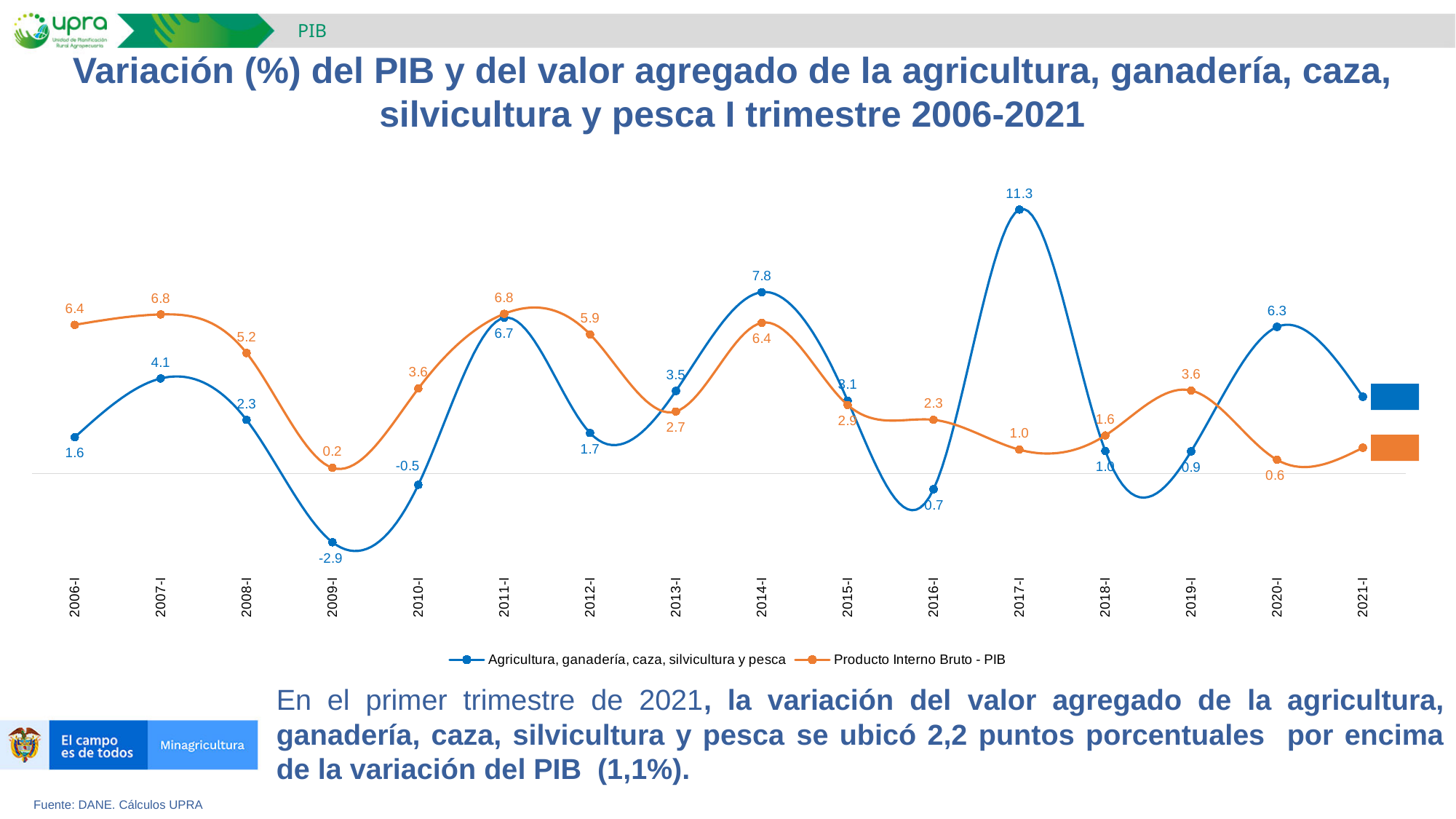
In 2012-I, which series has the larger value: Agricultura, ganadería, caza, silvicultura y pesca or Producto Interno Bruto - PIB? Producto Interno Bruto - PIB What kind of chart is shown on the slide? Line chart In which period does the Producto Interno Bruto - PIB series reach its lowest value? 2009-I What is the difference between the Agricultura, ganadería, caza, silvicultura y pesca value and the PIB value in 2014-I? 1.4 How many series does the legend list? 2 In which period does the Agricultura, ganadería, caza, silvicultura y pesca series reach its highest value? 2017-I What is the value for Agricultura, ganadería, caza, silvicultura y pesca in 2009-I? -2.9 What is the value for Producto Interno Bruto - PIB in 2020-I? 0.6 What is the value for Agricultura, ganadería, caza, silvicultura y pesca in 2017-I? 11.3 How many periods are shown on the x axis? 16 What is the value for Producto Interno Bruto - PIB in 2008-I? 5.2 In which period does the Agricultura, ganadería, caza, silvicultura y pesca series reach its lowest value? 2009-I